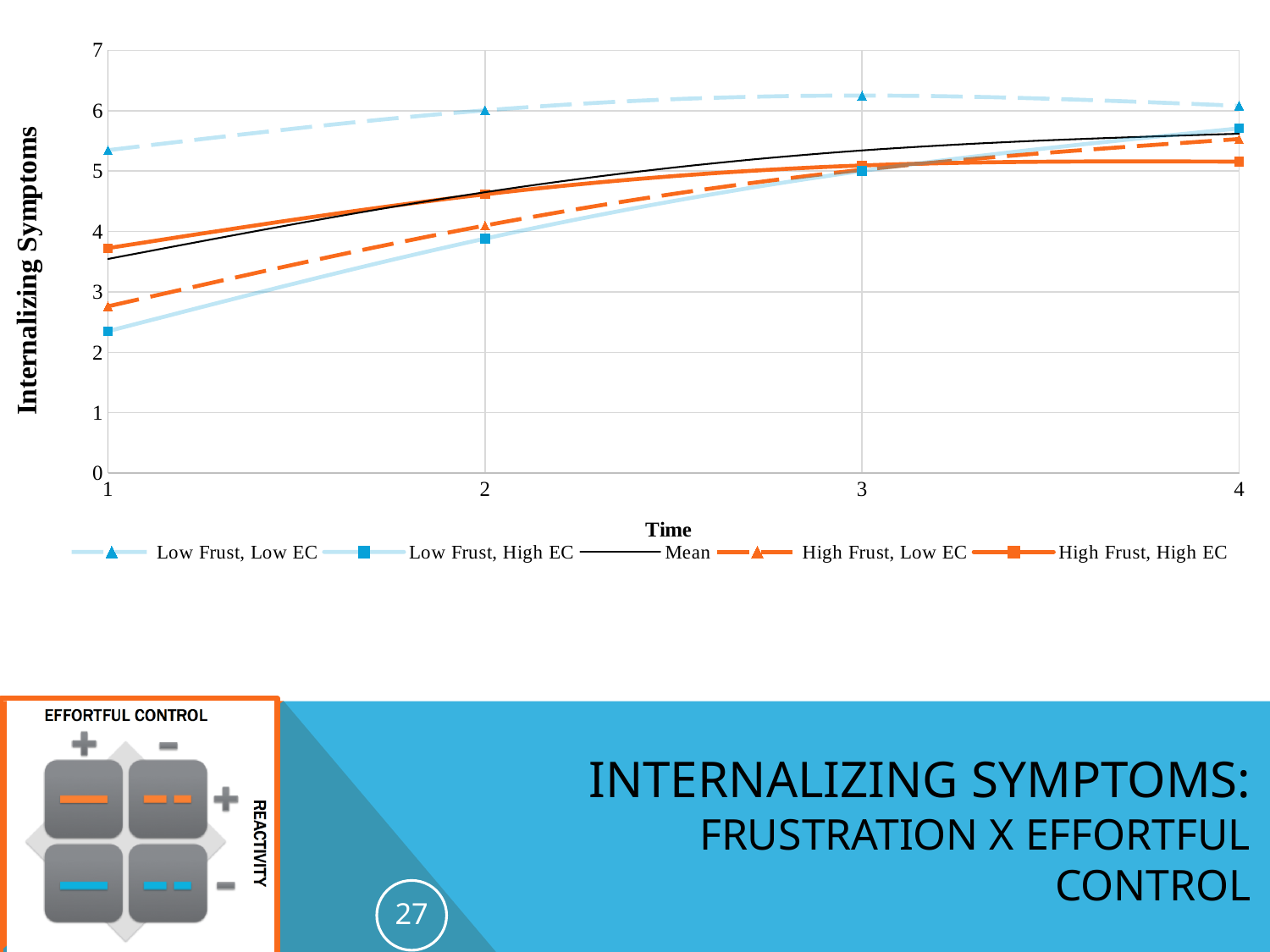
What kind of chart is shown on the slide? line chart Which series has the highest value at time 1? Low Frust, Low EC What is the title of the x axis? Time How many time points are plotted along the x axis? 4 Is the value for Low Frust, Low EC at time 1 greater or less than 5? greater Which series has the lowest value at time 1? Low Frust, High EC How many series does the legend list? 5 Is the value for High Frust, High EC at time 1 greater or less than 4? less What is the title of the y axis? Internalizing Symptoms Is the value for Low Frust, Low EC at time 3 greater or less than 6? greater Does the Low Frust, High EC line rise or fall from time 1 to time 4? rise